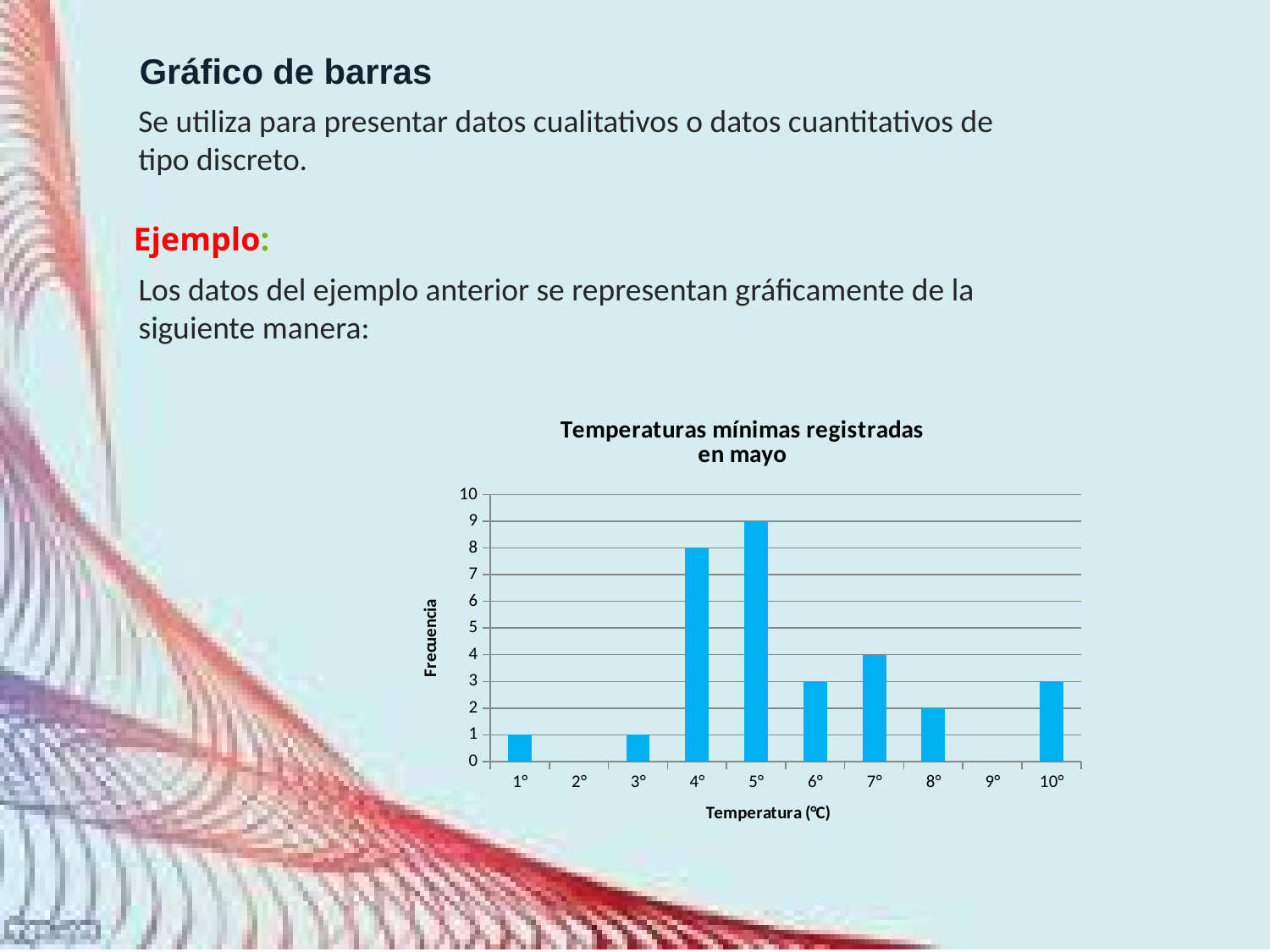
What is the title of the chart? Temperaturas mínimas registradas en mayo What is the difference between the frequencies for 5° and 4°? 1 What type of chart is shown on the slide? bar chart Which temperature has the highest frequency? 5° What is the frequency for 4°? 8 Which has a higher frequency, 6° or 7°? 7° What is the frequency for 7°? 4 How many temperature categories are shown on the x axis? 10 Is the frequency for 4° greater or less than 5? greater What is the frequency for 5°? 9 What is the label of the y axis? Frecuencia What is the frequency for 8°? 2